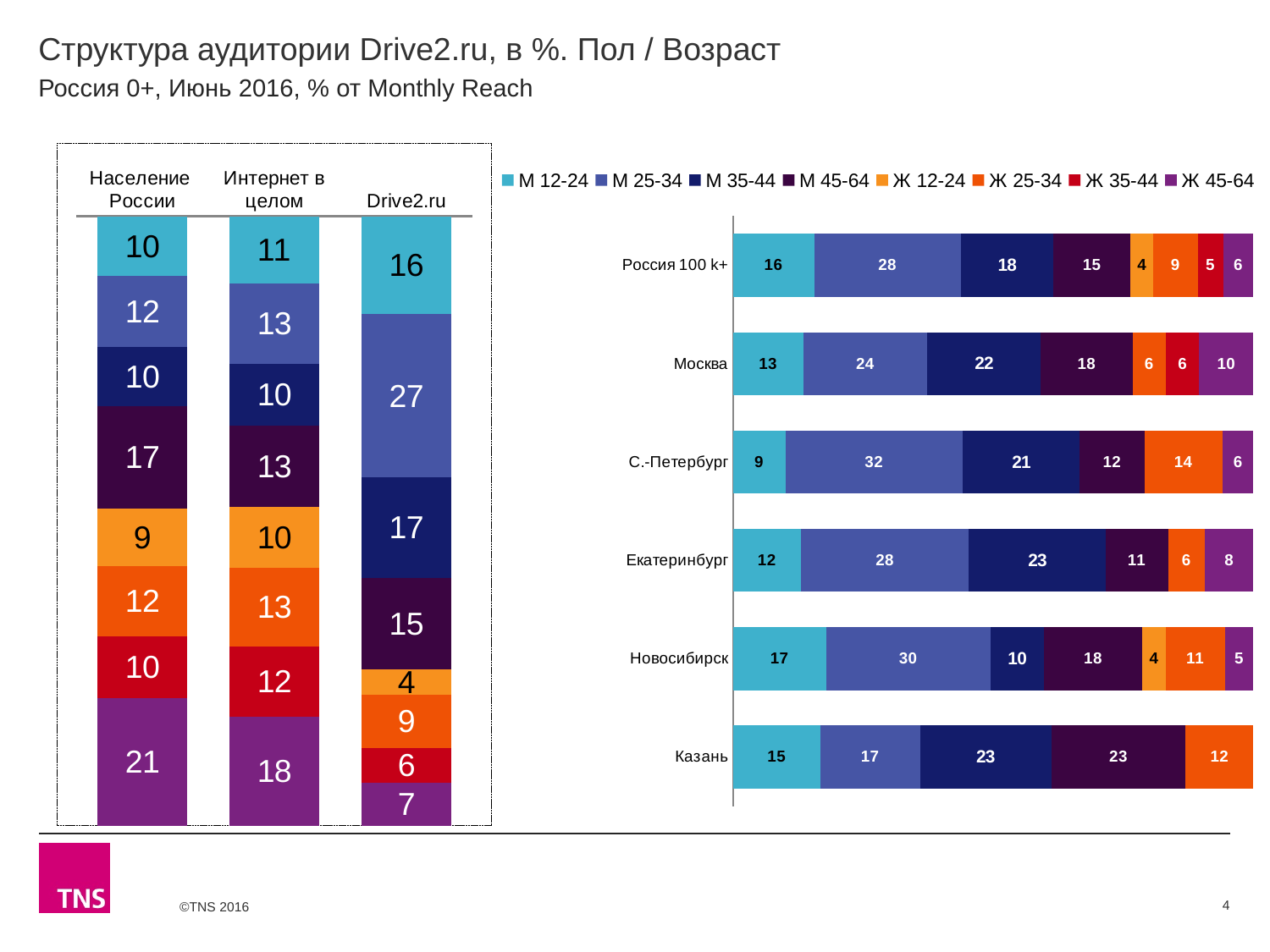
What kind of chart is the right chart? Stacked bar chart How many series does the legend list? 8 In the left chart, what is the value for Ж 45-64 in the Население России bar? 21 In the right chart, what is the value for М 25-34 for С.-Петербург? 32 In the left chart, which segment of the Drive2.ru bar is the largest? М 25-34 In the left chart, what is the value for М 25-34 in the Drive2.ru bar? 27 In the left chart, which segment of the Drive2.ru bar is the smallest? Ж 12-24 In the right chart, which city has the lowest М 12-24 value? С.-Петербург In the right chart, which is larger: the М 35-44 value for Москва or for Казань? Казань In the right chart, what is the value for М 12-24 for Новосибирск? 17 In the right chart, which city has the highest М 25-34 value? С.-Петербург In the left chart, what is the difference between the М 12-24 values for Drive2.ru and Население России? 6